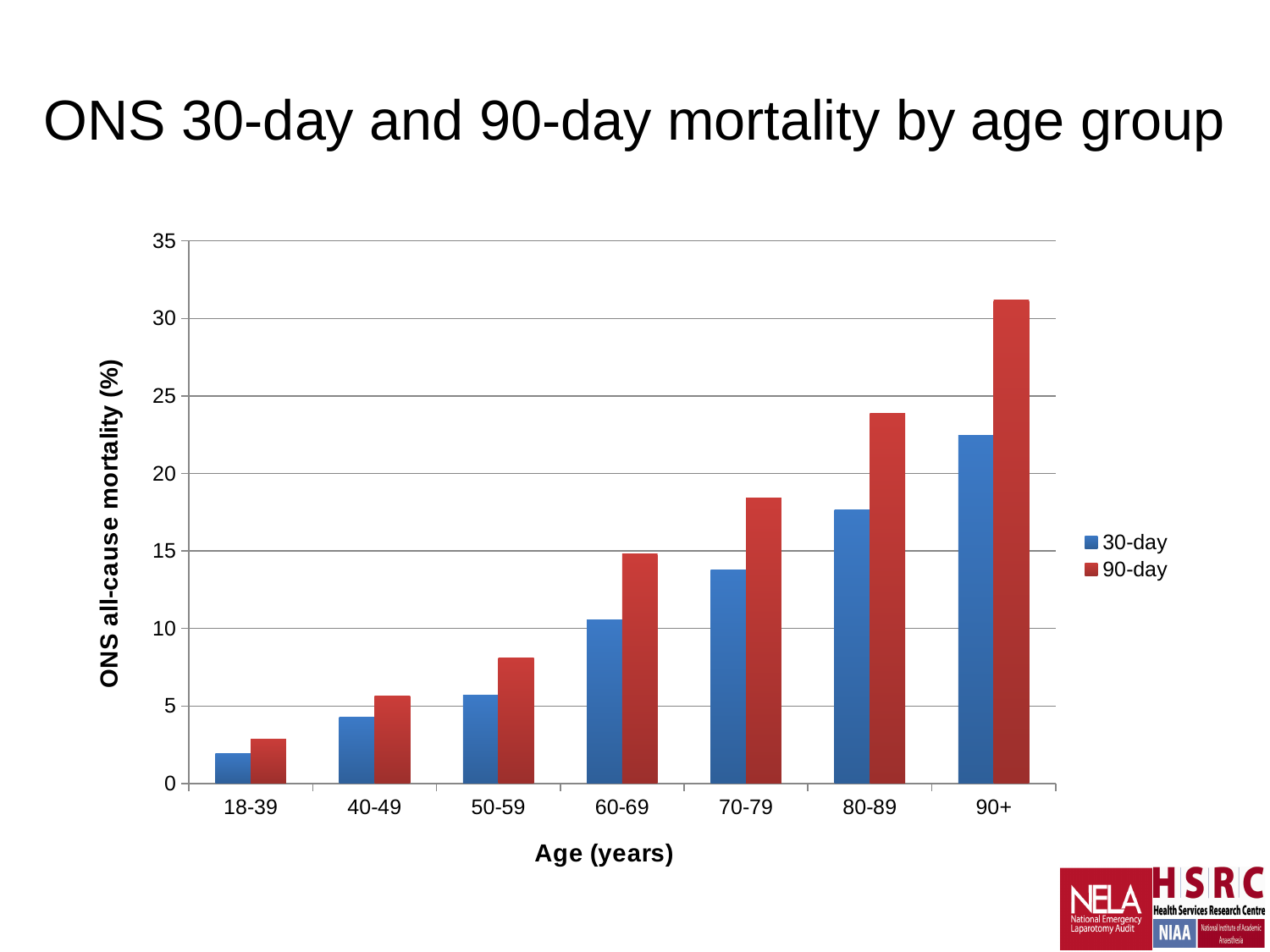
How many series does the legend list? 2 Which age group has the lowest 30-day mortality? 18-39 Is the 90-day mortality for the 18-39 age group greater or less than 5? less Is the 90-day mortality for the 90+ age group greater or less than 30? greater Which is larger for the 60-69 age group, the 30-day or the 90-day mortality? 90-day Do the 30-day mortality values rise or fall as age increases along the x axis? rise Which age group has the highest 90-day mortality? 90+ What is the label of the y axis? ONS all-cause mortality (%) What kind of chart is shown on the slide? bar chart Is the 90-day mortality for the 80-89 age group greater or less than 25? less How many age groups are shown on the x axis? 7